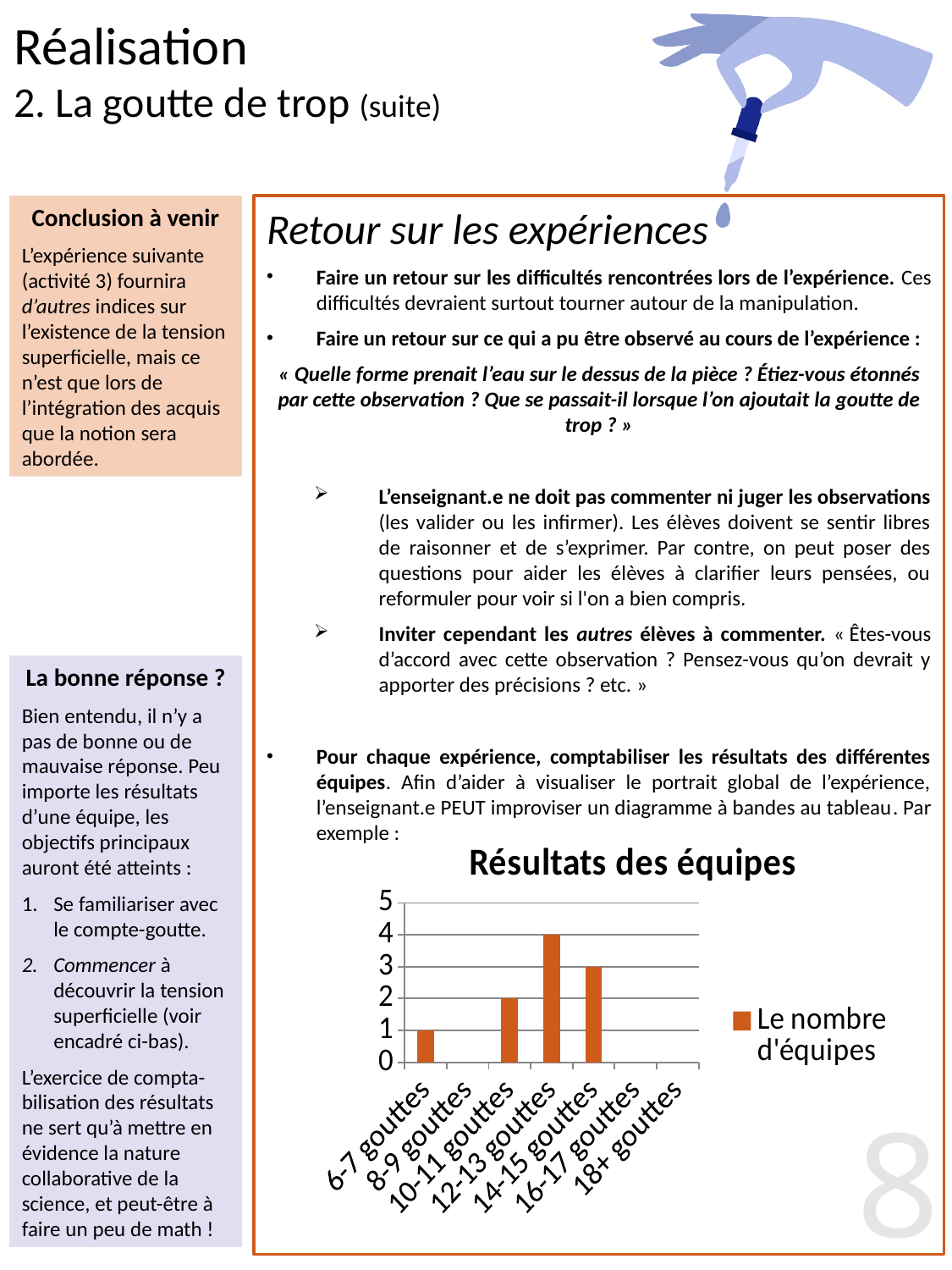
What is the value for 12-13 gouttes in the chart? 4 What is the title of the chart on the slide? Résultats des équipes What is the legend entry of the chart? Le nombre d'équipes How many categories are shown on the x axis of the chart? 7 What is the value for 14-15 gouttes in the chart? 3 What type of chart is shown under the title "Résultats des équipes"? bar chart What is the value for 6-7 gouttes in the chart? 1 What is the value for 10-11 gouttes in the chart? 2 How many series does the legend of the chart list? 1 Which is larger in the chart, the value for 14-15 gouttes or the value for 6-7 gouttes? 14-15 gouttes What is the difference between the values for 12-13 gouttes and 10-11 gouttes? 2 Which category has the highest value in the chart? 12-13 gouttes